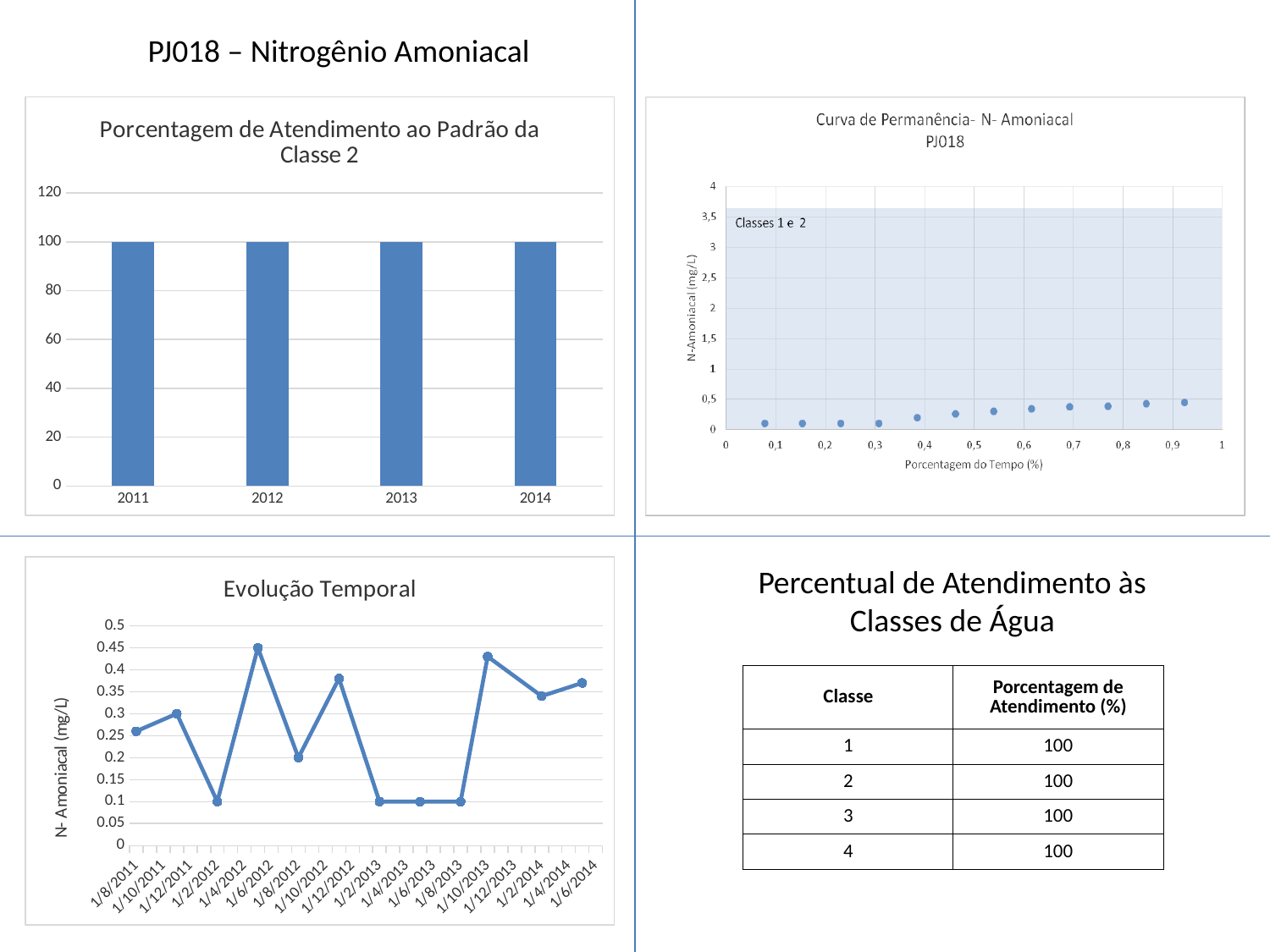
In the chart titled "Curva de Permanência- N- Amoniacal PJ018", is the highest plotted point greater or less than 0.5 mg/L? less What kind of chart is the one titled "Porcentagem de Atendimento ao Padrão da Classe 2"? bar chart In the chart titled "Porcentagem de Atendimento ao Padrão da Classe 2", is the value for 2014 greater or less than 80? greater In the chart titled "Evolução Temporal", what is the value for 1/6/2012? 0.45 In the chart titled "Evolução Temporal", is the value for 1/10/2013 greater or less than 0.4? greater What kind of chart is the one titled "Curva de Permanência- N- Amoniacal PJ018"? scatter chart In the chart titled "Evolução Temporal", which is larger, the value for 1/10/2011 or the value for 1/8/2012? 1/10/2011 In the chart titled "Evolução Temporal", what is the value for 1/2/2012? 0.1 In the chart titled "Porcentagem de Atendimento ao Padrão da Classe 2", how many years are shown on the x axis? 4 In the chart titled "Porcentagem de Atendimento ao Padrão da Classe 2", what is the difference between the values for 2011 and 2013? 0 What is the y-axis label of the chart titled "Evolução Temporal"? N- Amoniacal (mg/L) In the chart titled "Porcentagem de Atendimento ao Padrão da Classe 2", what is the value for 2012? 100